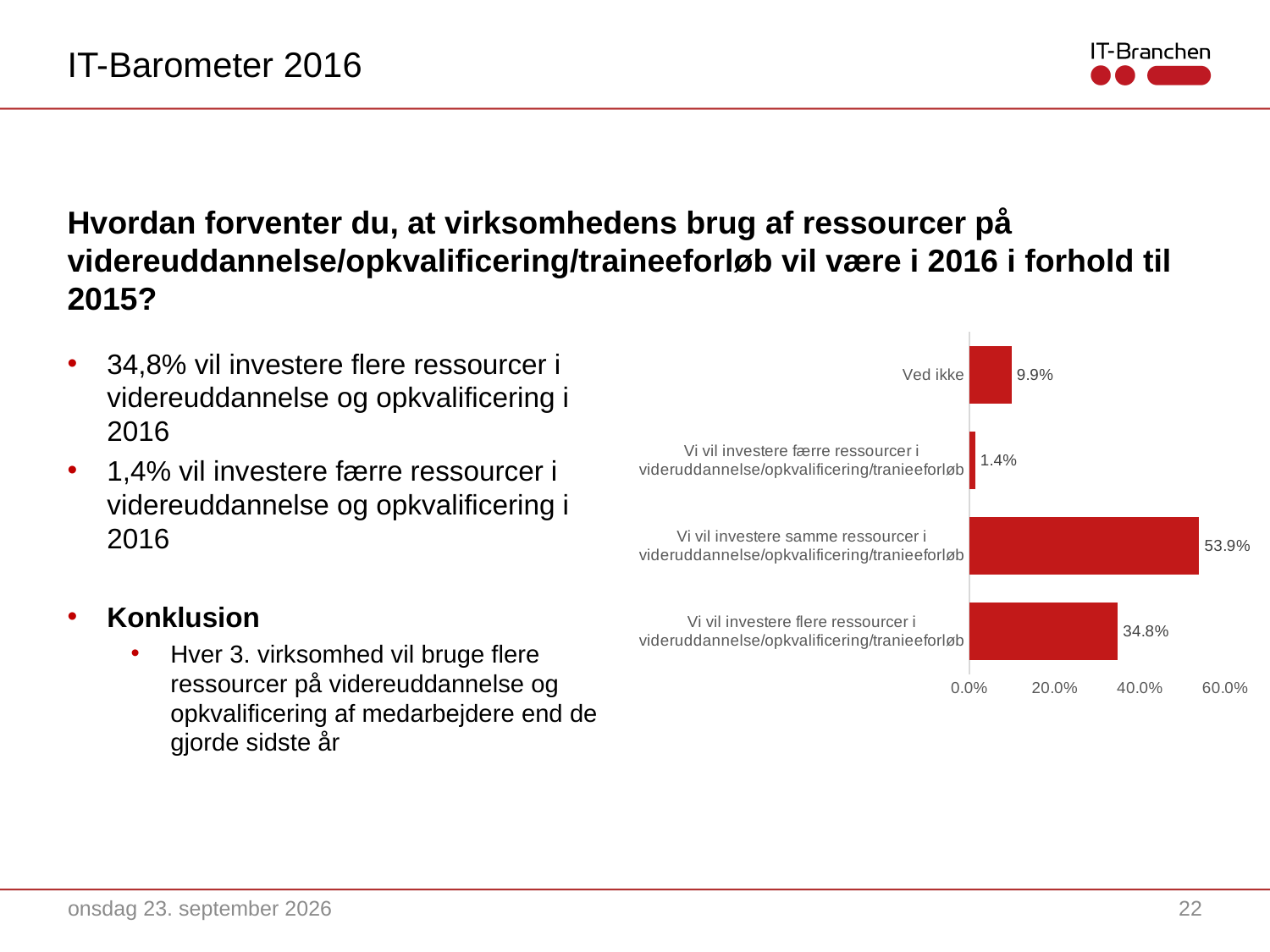
What is the highest value shown on the x axis of the chart? 60.0% Is the value for "Vi vil investere samme ressourcer" greater or less than 40.0%? greater What is the value for "Vi vil investere færre ressourcer i videruddannelse/opkvalificering/tranieeforløb"? 1.4% What is the difference between the value for "Vi vil investere samme ressourcer" and the value for "Vi vil investere flere ressourcer"? 19.1% What is the value for "Ved ikke"? 9.9% How many categories are shown in the chart? 4 What is the value for "Vi vil investere samme ressourcer i videruddannelse/opkvalificering/tranieeforløb"? 53.9% Which category has the lowest value? Vi vil investere færre ressourcer i videruddannelse/opkvalificering/tranieeforløb What kind of chart is shown on the slide? bar chart Which is larger: the value for "Ved ikke" or the value for "Vi vil investere færre ressourcer"? Ved ikke Which category has the highest value? Vi vil investere samme ressourcer i videruddannelse/opkvalificering/tranieeforløb What is the value for "Vi vil investere flere ressourcer i videruddannelse/opkvalificering/tranieeforløb"? 34.8%